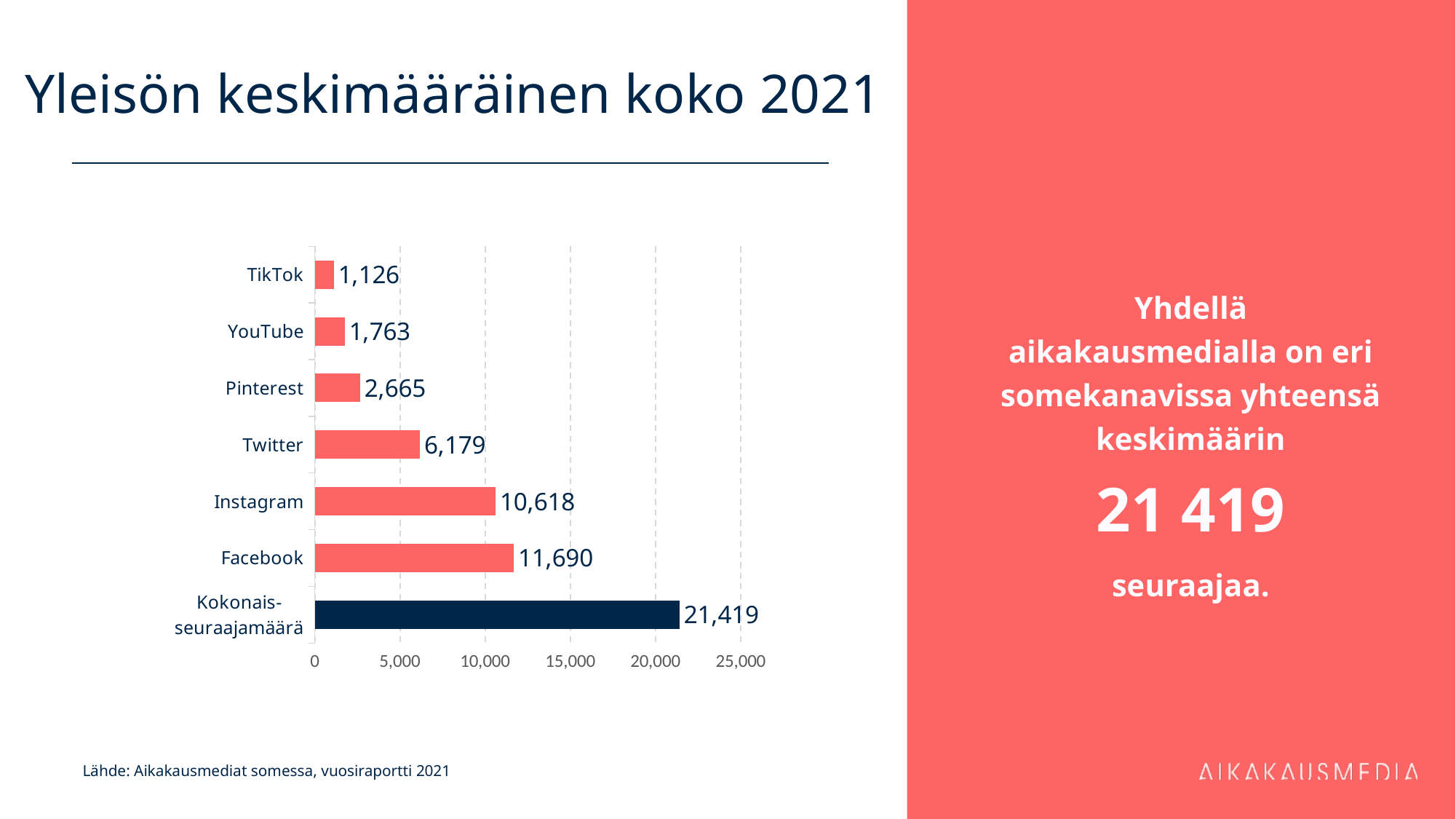
Is the value for Instagram greater or less than 10,000? greater What is the difference between the values for Facebook and Instagram? 1,072 How many categories are shown in the chart? 7 What is the value for Twitter? 6,179 Which category has the highest value? Kokonais-seuraajamäärä What is the value for Kokonais-seuraajamäärä? 21,419 Which is larger, the value for Pinterest or the value for YouTube? Pinterest What is the value for TikTok? 1,126 What kind of chart is shown on the slide? bar chart What is the value for Facebook? 11,690 What is the title of the slide? Yleisön keskimääräinen koko 2021 Which category has the lowest value? TikTok